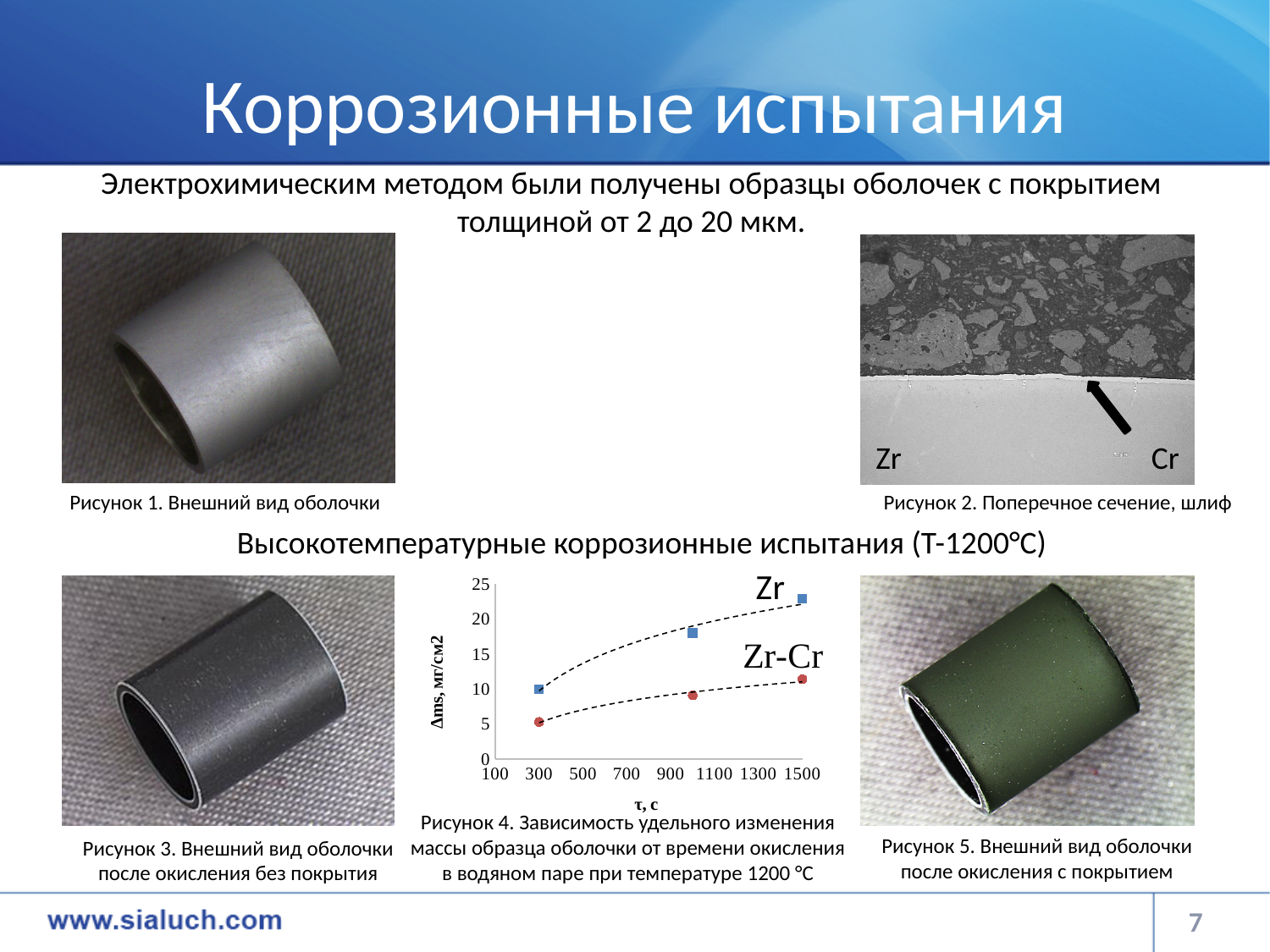
In the chart (Рисунок 4), is the value of the Zr-Cr series at τ = 300 с greater or less than 10? less What kind of chart is Рисунок 4 on the slide? scatter chart How many data series are plotted in the chart (Рисунок 4)? 2 In the chart (Рисунок 4), is the value of the Zr-Cr series at τ = 1500 с greater or less than 15? less What are the names of the two series shown in the chart (Рисунок 4)? Zr and Zr-Cr In the chart (Рисунок 4), do the values of the Zr series rise or fall as τ increases? rise How many data points are plotted for the Zr-Cr series in the chart (Рисунок 4)? 3 In the chart (Рисунок 4), is the value of the Zr series at τ = 1500 с greater or less than 20? greater What is the label of the x axis in the chart (Рисунок 4)? τ, с In the chart (Рисунок 4), which series has the higher value at τ = 1500 с, Zr or Zr-Cr? Zr In the chart (Рисунок 4), which series reaches the highest Δms value? Zr